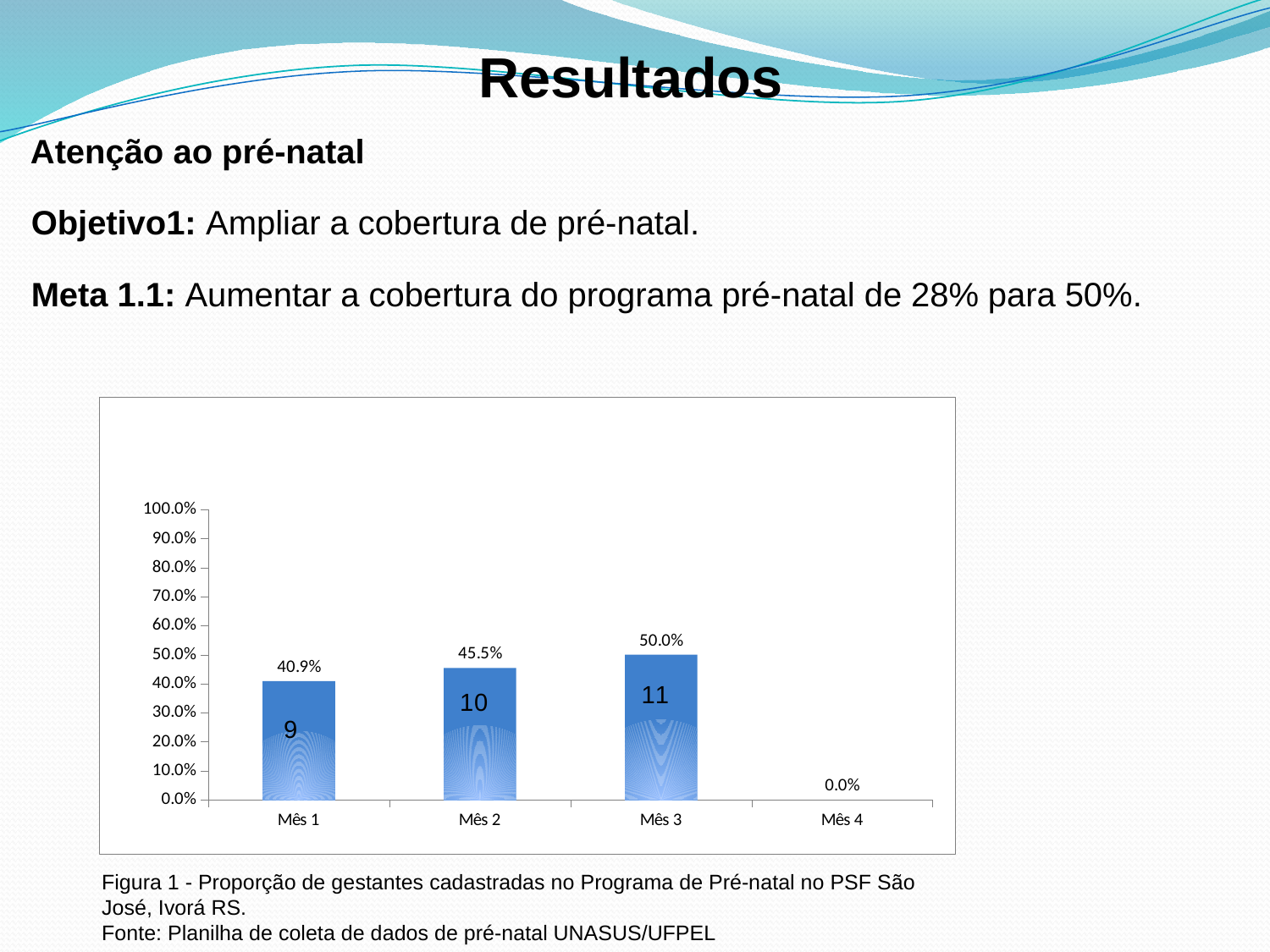
What is the value for Mês 1? 40.9% What is the value for Mês 4? 0.0% Do the values rise or fall from Mês 1 to Mês 3? Rise How many months are shown on the x axis? 4 What number is printed inside the bar for Mês 2? 10 What kind of chart is shown on the slide? Bar chart Which month has the highest value? Mês 3 Which is larger, the value for Mês 2 or the value for Mês 1? Mês 2 What is the difference between the values for Mês 3 and Mês 1? 9.1% Which month has the lowest value? Mês 4 What is the value for Mês 3? 50.0% What is the value for Mês 2? 45.5%